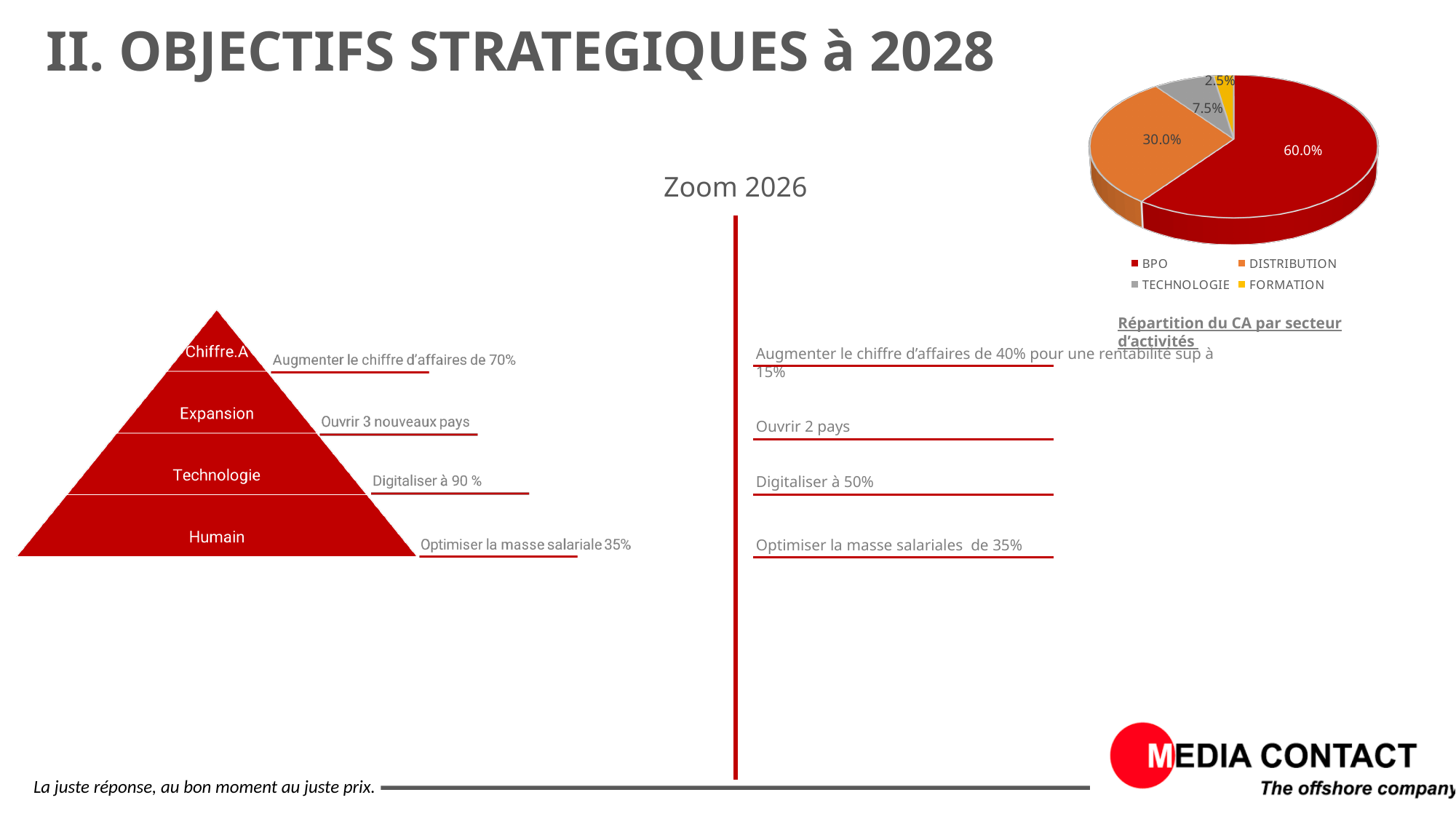
In the pie chart, what is the difference between the BPO share and the DISTRIBUTION share? 30.0% In the pie chart, what share of CA does TECHNOLOGIE represent? 7.5% In the pie chart's legend, which colour represents DISTRIBUTION? Orange Which sector has the largest slice in the pie chart? BPO What kind of chart is shown in the top right of the slide? Pie chart In the pie chart, what share of CA does FORMATION represent? 2.5% How many sectors does the pie chart's legend list? 4 In the pie chart, which is larger: TECHNOLOGIE or FORMATION? TECHNOLOGIE In the pie chart, what share of CA does DISTRIBUTION represent? 30.0% Which sector has the smallest slice in the pie chart? FORMATION What is the title of the pie chart? Répartition du CA par secteur d'activités In the pie chart, what share of CA does BPO represent? 60.0%